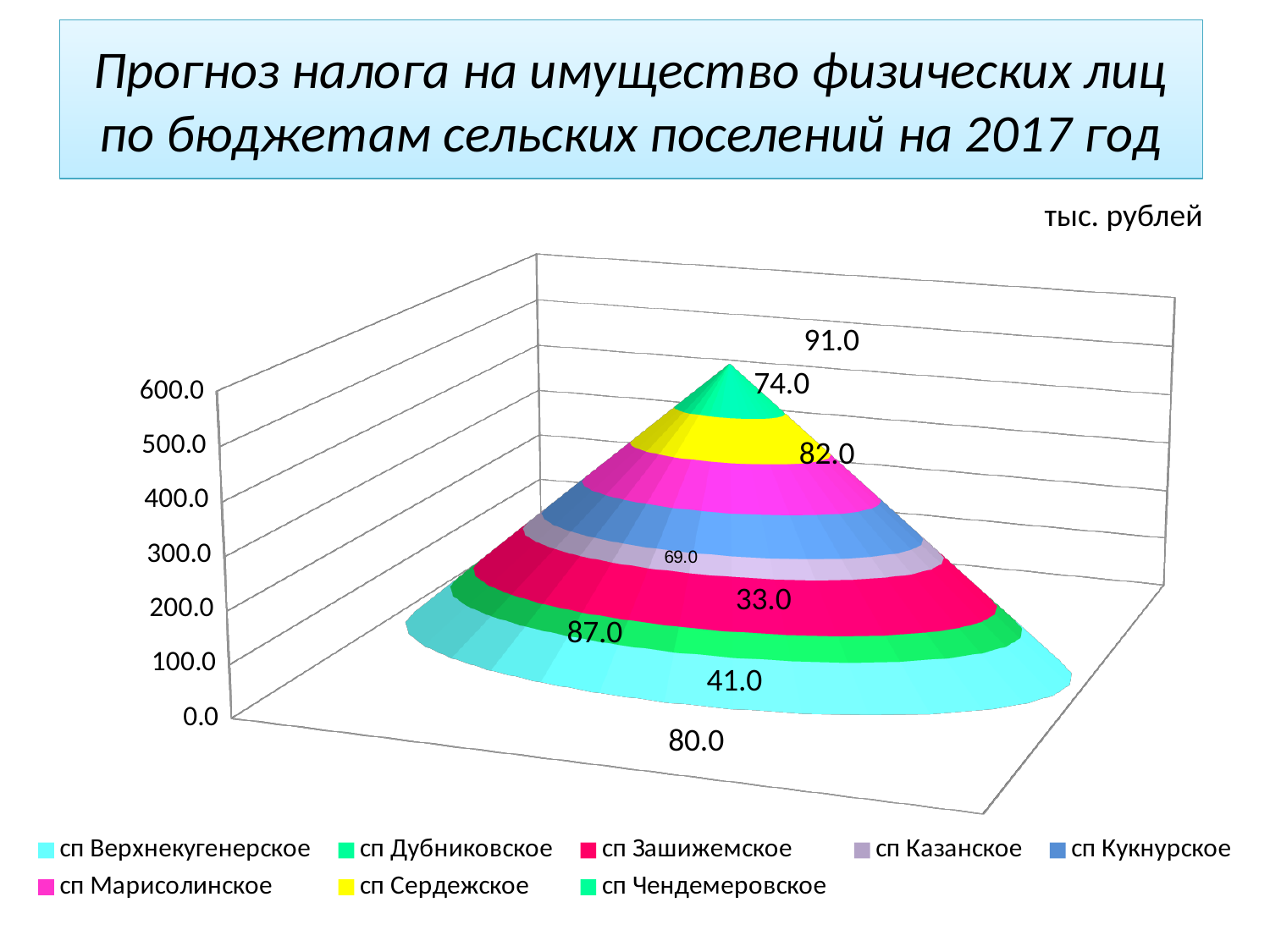
What is the value for сп Чендемеровское (the top segment)? 91.0 What is the value for сп Марисолинское? 82.0 What unit is stated for the values on the chart? тыс. рублей What is the total of all the stacked segments? 557.0 What is the smallest data label shown on the chart? 33.0 How many series does the legend list? 8 What is the largest data label shown on the chart? 91.0 What is the highest value shown on the vertical axis? 600.0 What is the difference between the largest label (91.0) and the smallest label (33.0)? 58.0 Which is larger, the value for сп Верхнекугенерское or the value for сп Дубниковское? сп Верхнекугенерское What is the value for сп Верхнекугенерское (the bottom segment)? 80.0 What is the value for сп Зашижемское? 87.0